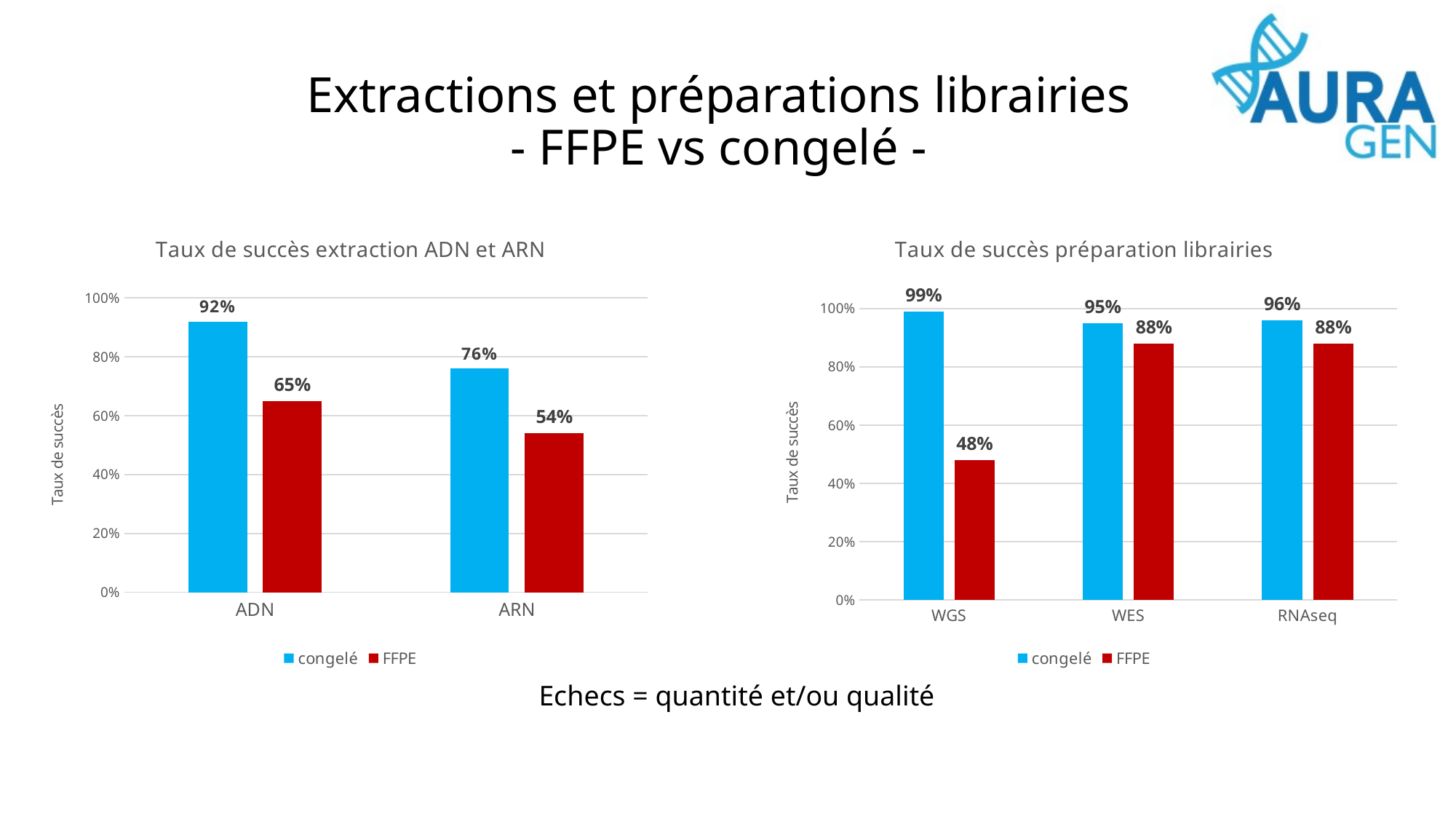
In the chart 'Taux de succès préparation librairies', how many categories are shown on the x axis? 3 In the chart 'Taux de succès préparation librairies', what is the difference between congelé and FFPE for WGS? 51% In the chart 'Taux de succès préparation librairies', what is the value for congelé for RNAseq? 96% In the chart 'Taux de succès préparation librairies', what is the value for FFPE for WGS? 48% In the chart 'Taux de succès préparation librairies', is the FFPE value for WES larger or smaller than the FFPE value for WGS? larger In the chart 'Taux de succès extraction ADN et ARN', which category has the lowest FFPE value? ARN In the chart 'Taux de succès préparation librairies', which category has the highest congelé value? WGS In the chart 'Taux de succès extraction ADN et ARN', what is the value for FFPE for ARN? 54% In the chart 'Taux de succès extraction ADN et ARN', what is the value for congelé for ADN? 92% What kind of chart is 'Taux de succès extraction ADN et ARN'? bar chart In the chart 'Taux de succès extraction ADN et ARN', what is the difference between congelé and FFPE for ADN? 27% In the chart 'Taux de succès extraction ADN et ARN', how many series does the legend list? 2